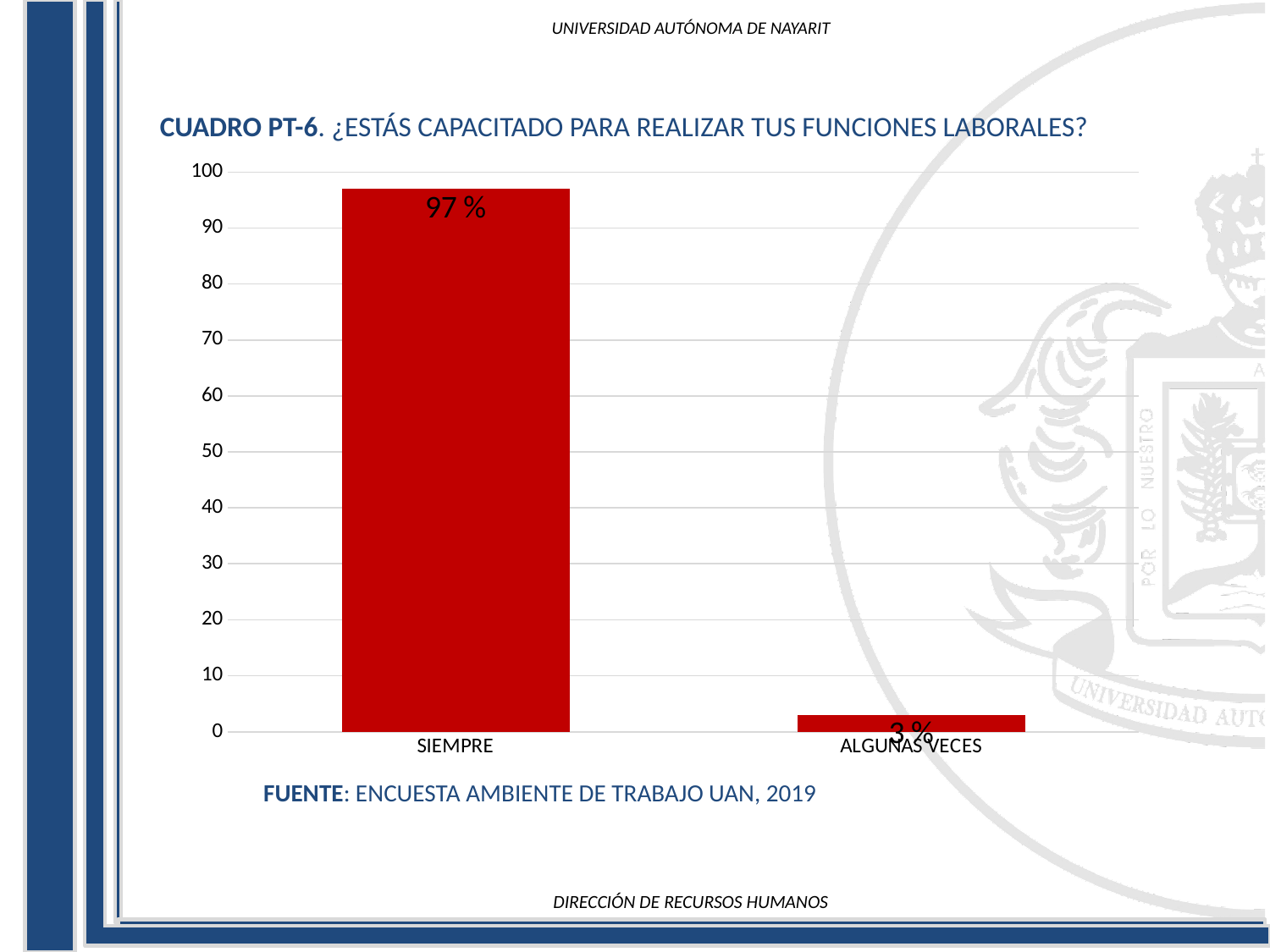
Which is larger, the value for SIEMPRE or the value for ALGUNAS VECES? SIEMPRE What is the value for SIEMPRE? 97 % What kind of chart is shown on the slide? bar chart What is the value for ALGUNAS VECES? 3 % What colour are the bars in the chart? red Is the value for SIEMPRE greater or less than 90? greater How many categories are shown on the x axis? 2 What is the highest value shown on the y axis? 100 Is the value for ALGUNAS VECES greater or less than 10? less Which category has the lowest value? ALGUNAS VECES What is the difference between the values for SIEMPRE and ALGUNAS VECES? 94 % Which category has the highest value? SIEMPRE